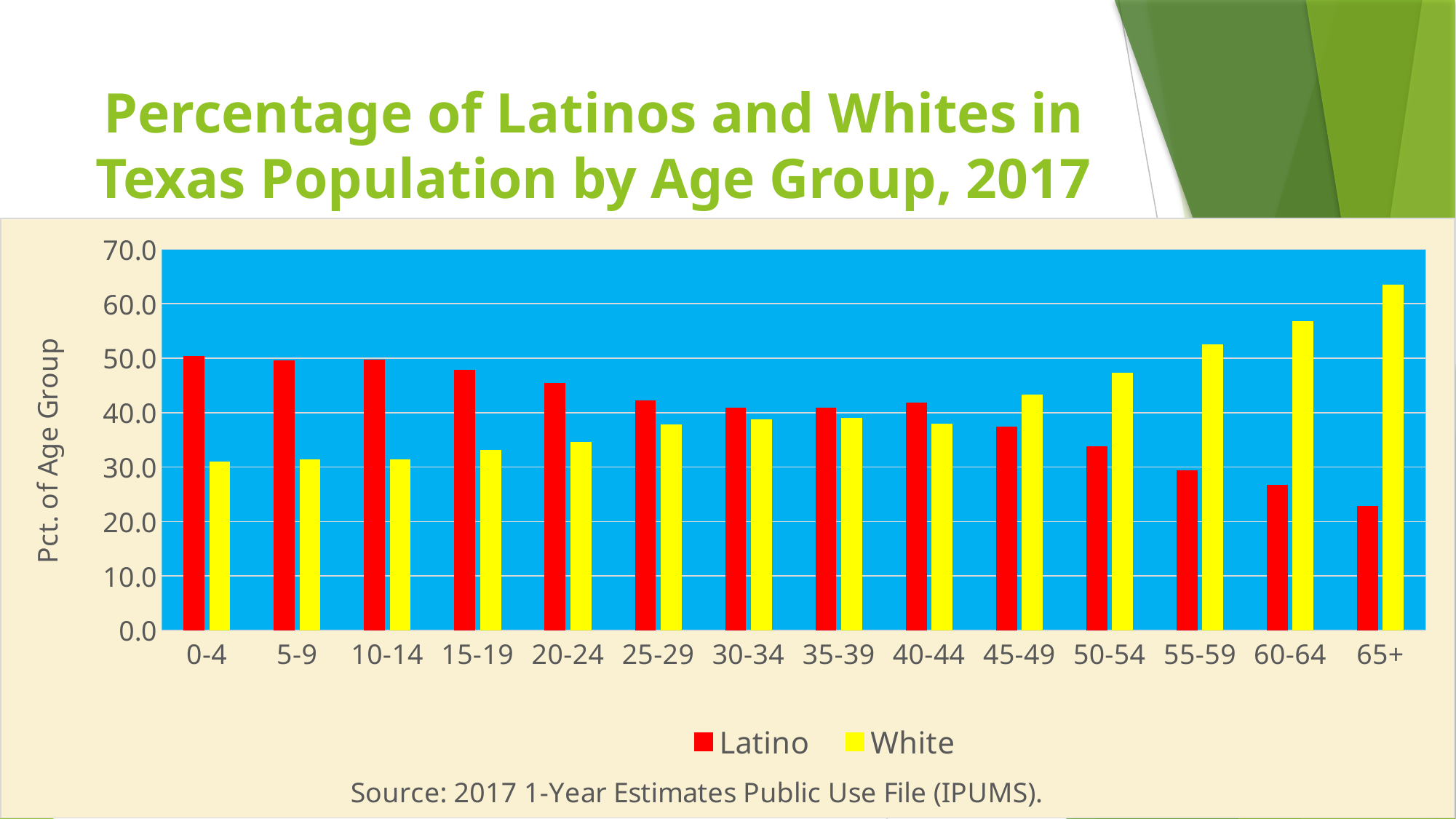
Is the Latino value for the 0-4 age group greater or less than 40.0? greater What kind of chart is shown on the slide? bar chart Is the White value for the 65+ age group greater or less than 60.0? greater For the 45-49 age group, which series has the larger value, Latino or White? White Do the Latino values generally rise or fall as the age groups increase along the x axis? fall Which age group has the highest value for the White series? 65+ Which age group has the lowest value for the Latino series? 65+ How many series does the legend list? 2 Is the White value for the 20-24 age group greater or less than 40.0? less For the 0-4 age group, which series has the larger value, Latino or White? Latino How many age groups are shown on the x axis? 14